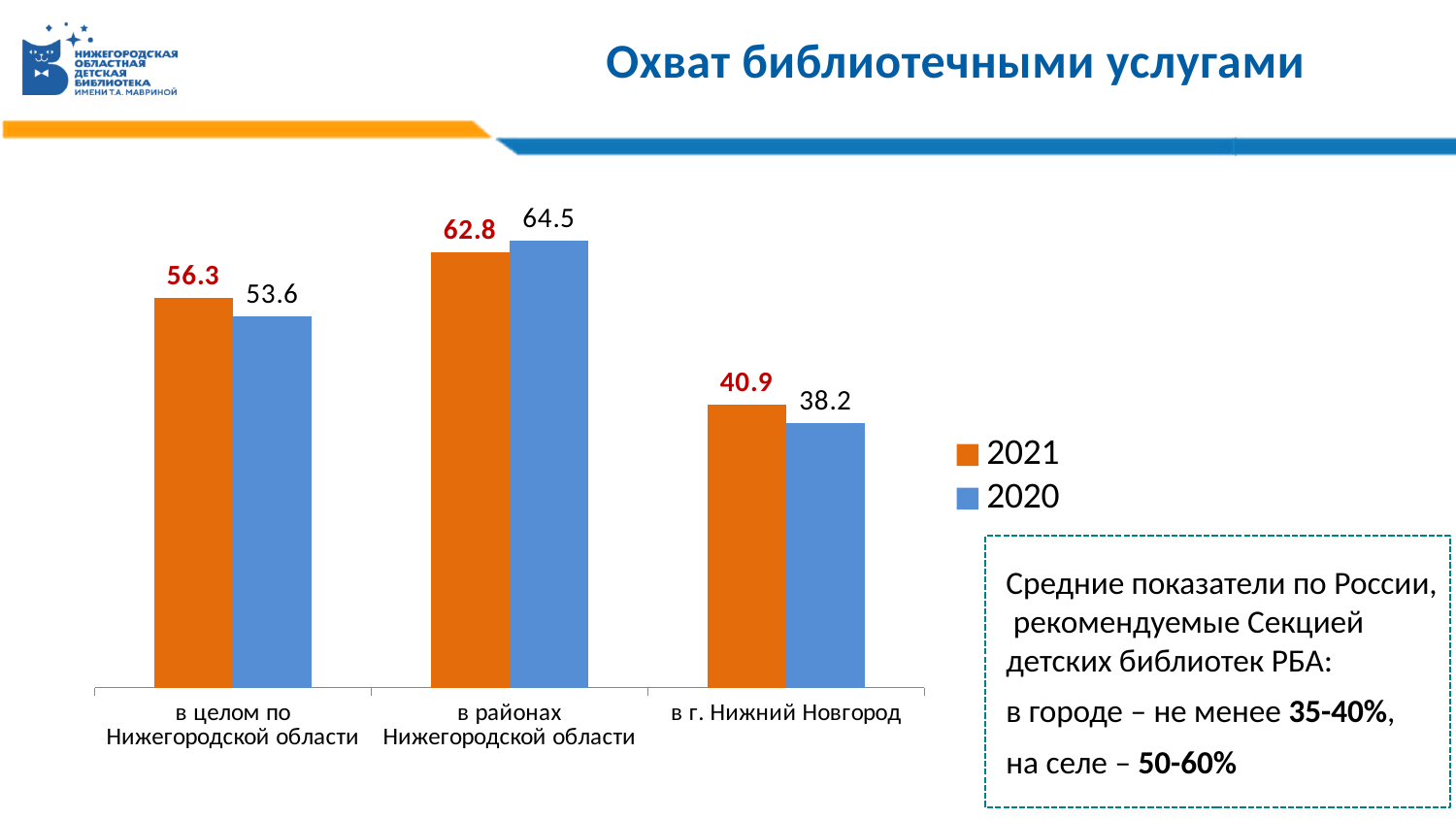
What is the difference between the 2021 and 2020 values for «в г. Нижний Новгород»? 2.7 What is the difference between the 2020 and 2021 values for «в районах Нижегородской области»? 1.7 What is the 2020 value for «в г. Нижний Новгород»? 38.2 What is the 2021 value for «в целом по Нижегородской области»? 56.3 For «в районах Нижегородской области», which year has the larger value, 2021 or 2020? 2020 For «в целом по Нижегородской области», which year has the larger value, 2021 or 2020? 2021 How many series does the legend list? 2 What is the 2020 value for «в районах Нижегородской области»? 64.5 What type of chart is shown on the slide? Bar chart How many categories are shown on the x axis? 3 Which category has the lowest 2020 value? в г. Нижний Новгород Which category has the highest 2021 value? в районах Нижегородской области